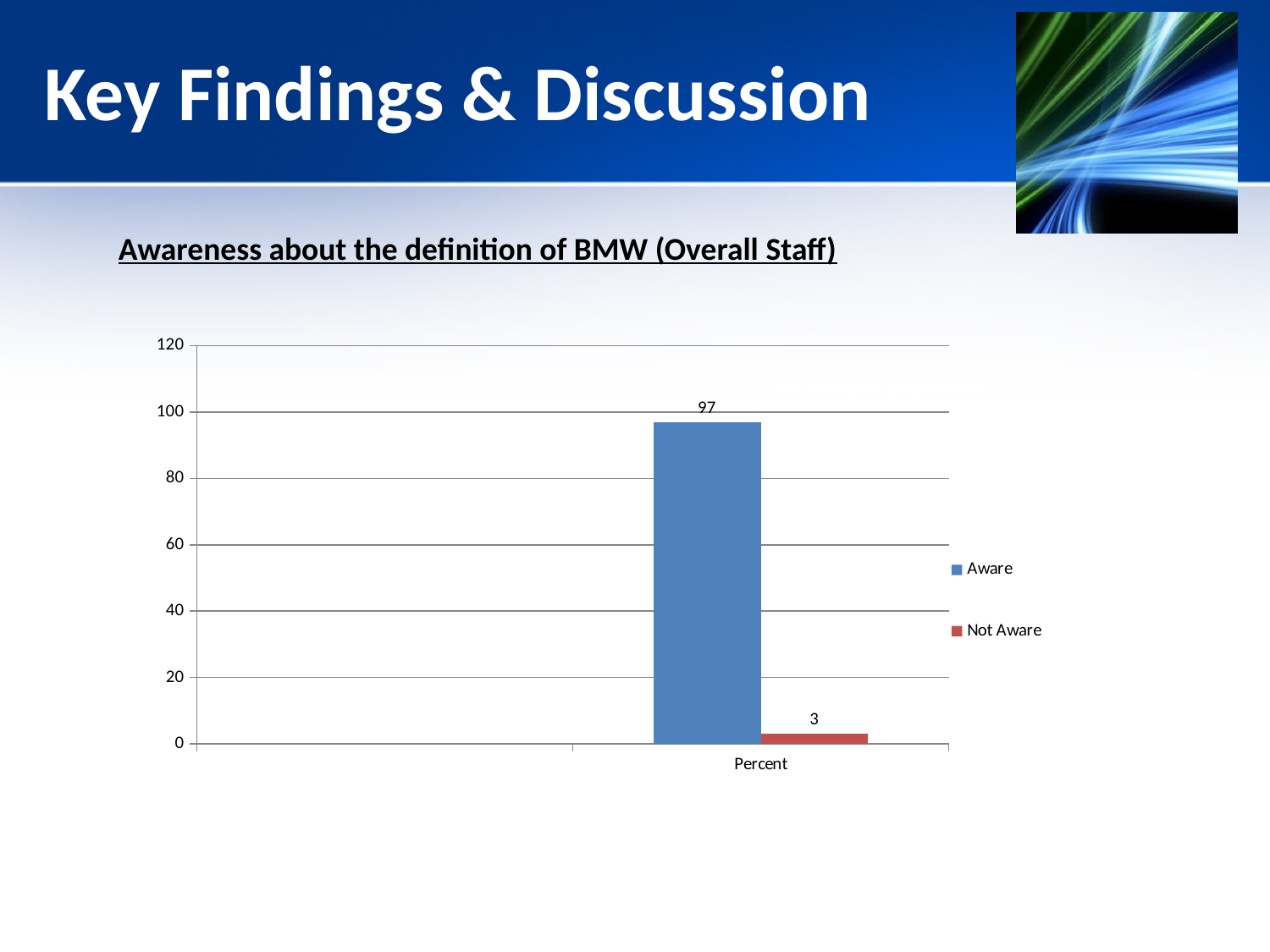
What is the value for Not Aware in the chart? 3 Which series has the lowest value in the chart? Not Aware What is the highest value shown on the y axis? 120 What is the title above the chart? Awareness about the definition of BMW (Overall Staff) Which series has the higher value, Aware or Not Aware? Aware Is the value for Not Aware greater or less than 20? less Is the value for Aware greater or less than 80? greater What kind of chart is shown on the slide? bar chart What is the value for Aware in the chart? 97 What is the label on the x axis category? Percent What is the difference between the Aware and Not Aware values? 94 How many series does the legend list? 2